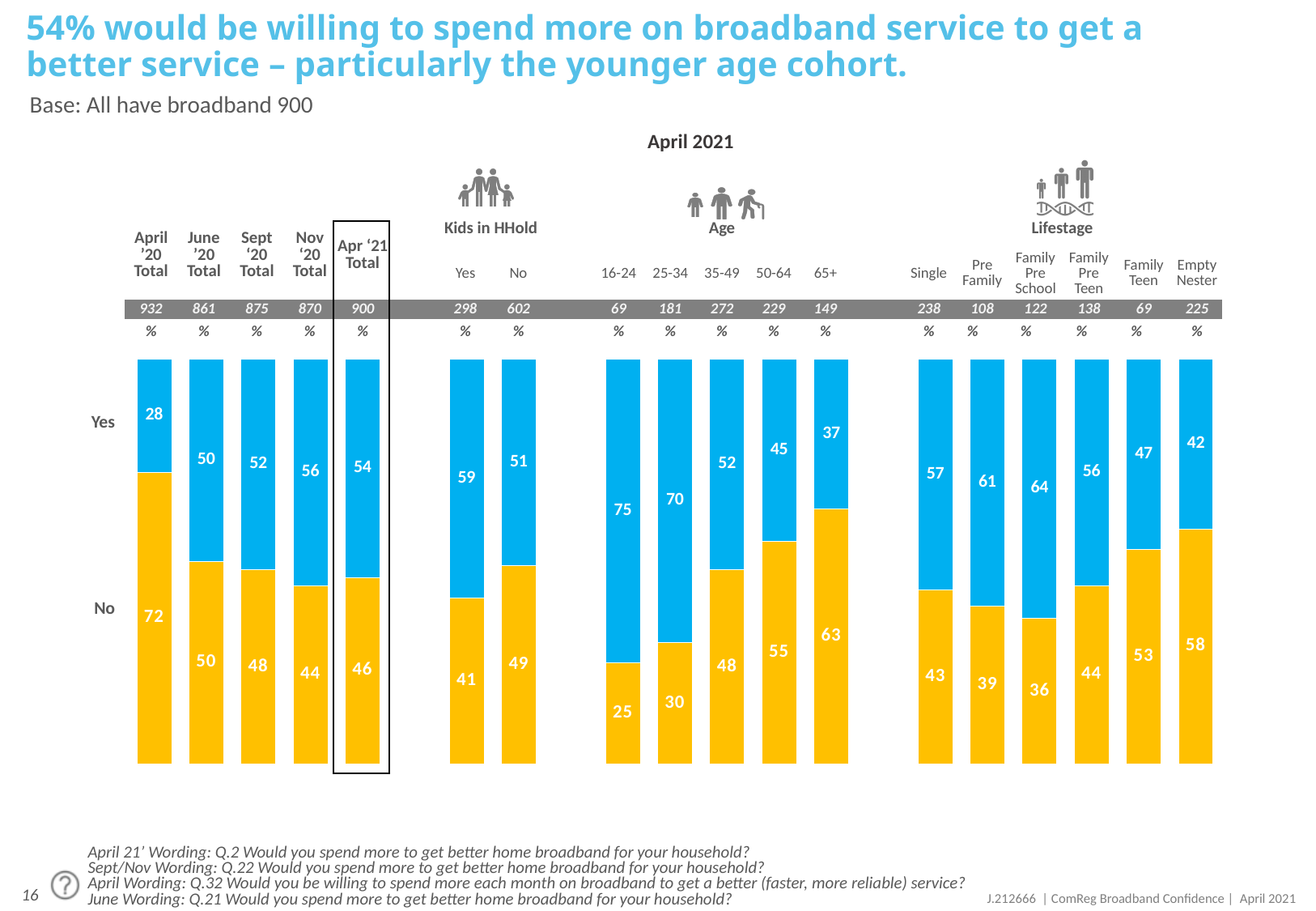
Which age group has the highest Yes percentage? 16-24 Which lifestage group has the lowest Yes percentage? Empty Nester What kind of chart is shown on the slide? Stacked bar chart How many age groups are shown in the chart? 5 What is the difference between the Yes percentage for 16-24 and the Yes percentage for 65+? 38 What percentage of the Apr '21 Total said Yes to spending more on broadband? 54 What is the No percentage for the 16-24 age group? 25 Is the Yes percentage higher for households with kids (Yes) or without kids (No)? Yes (59) What is the Yes percentage for the Family Pre School lifestage group? 64 What is the total of the Yes and No percentages for the Single group? 100 What is the base size shown for the Apr '21 Total? 900 How did the Yes percentage change from April '20 Total to Nov '20 Total? It rose from 28 to 56